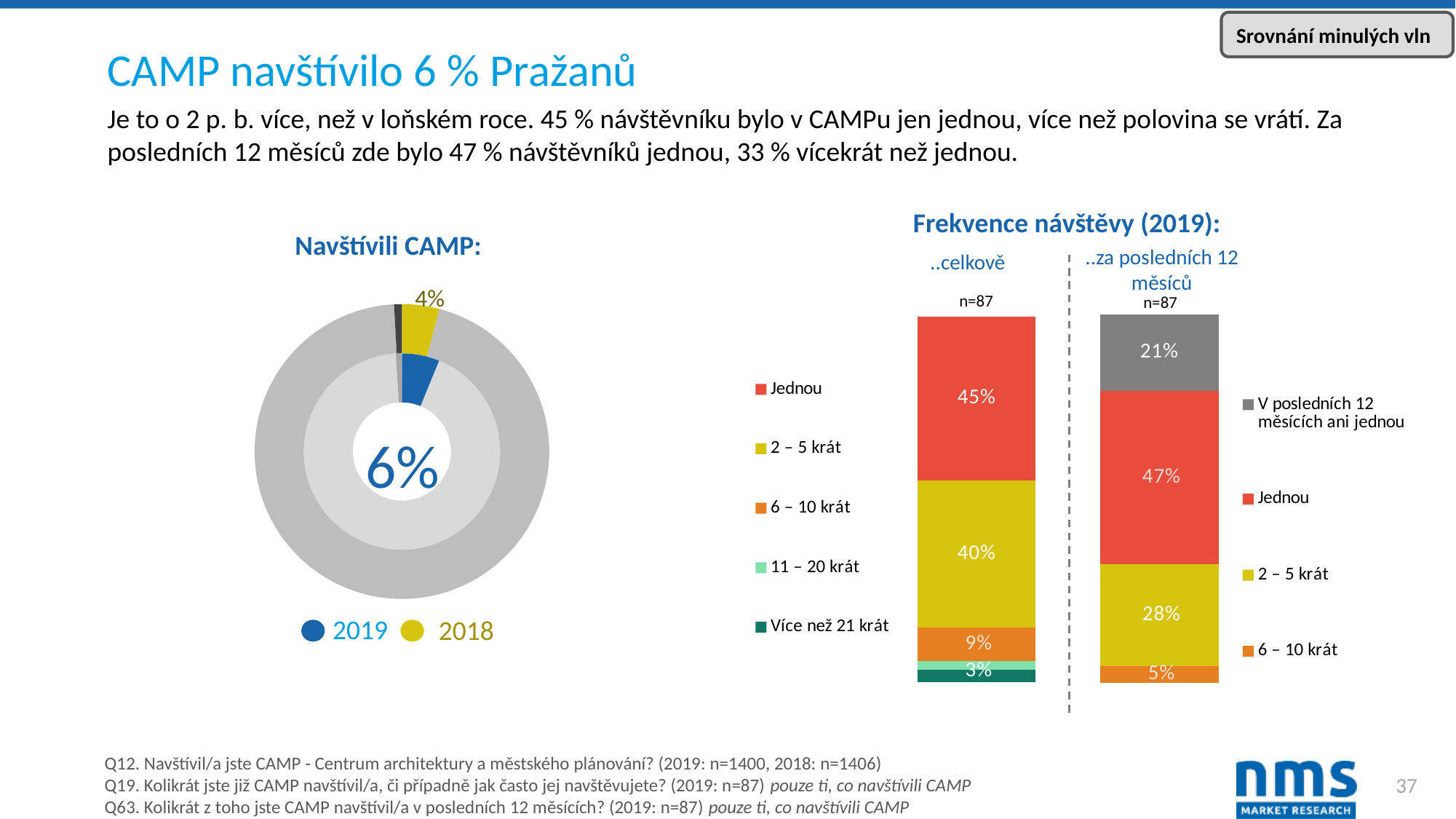
In the '..celkově' stacked bar, what is the value for '2 – 5 krát'? 40% In the '..celkově' stacked bar, which category has the largest share? Jednou How many categories does the legend of the '..celkově' chart list? 5 In the '..za posledních 12 měsíců' stacked bar, what is the value for 'Jednou'? 47% In the '..celkově' stacked bar, what is the value for '6 – 10 krát'? 9% In the 'Navštívili CAMP:' chart, what kind of chart is used? Donut (pie) chart In the '..za posledních 12 měsíců' stacked bar, what is the value for 'V posledních 12 měsících ani jednou'? 21% What is the difference between the '2 – 5 krát' value in the '..celkově' bar and in the '..za posledních 12 měsíců' bar? 12% In the '..za posledních 12 měsíců' stacked bar, what is the value for '6 – 10 krát'? 5% In the 'Navštívili CAMP:' chart, what is the value for 2018? 4% In the 'Navštívili CAMP:' chart, what is the value for 2019? 6% In the '..celkově' stacked bar, what is the value for 'Jednou'? 45%